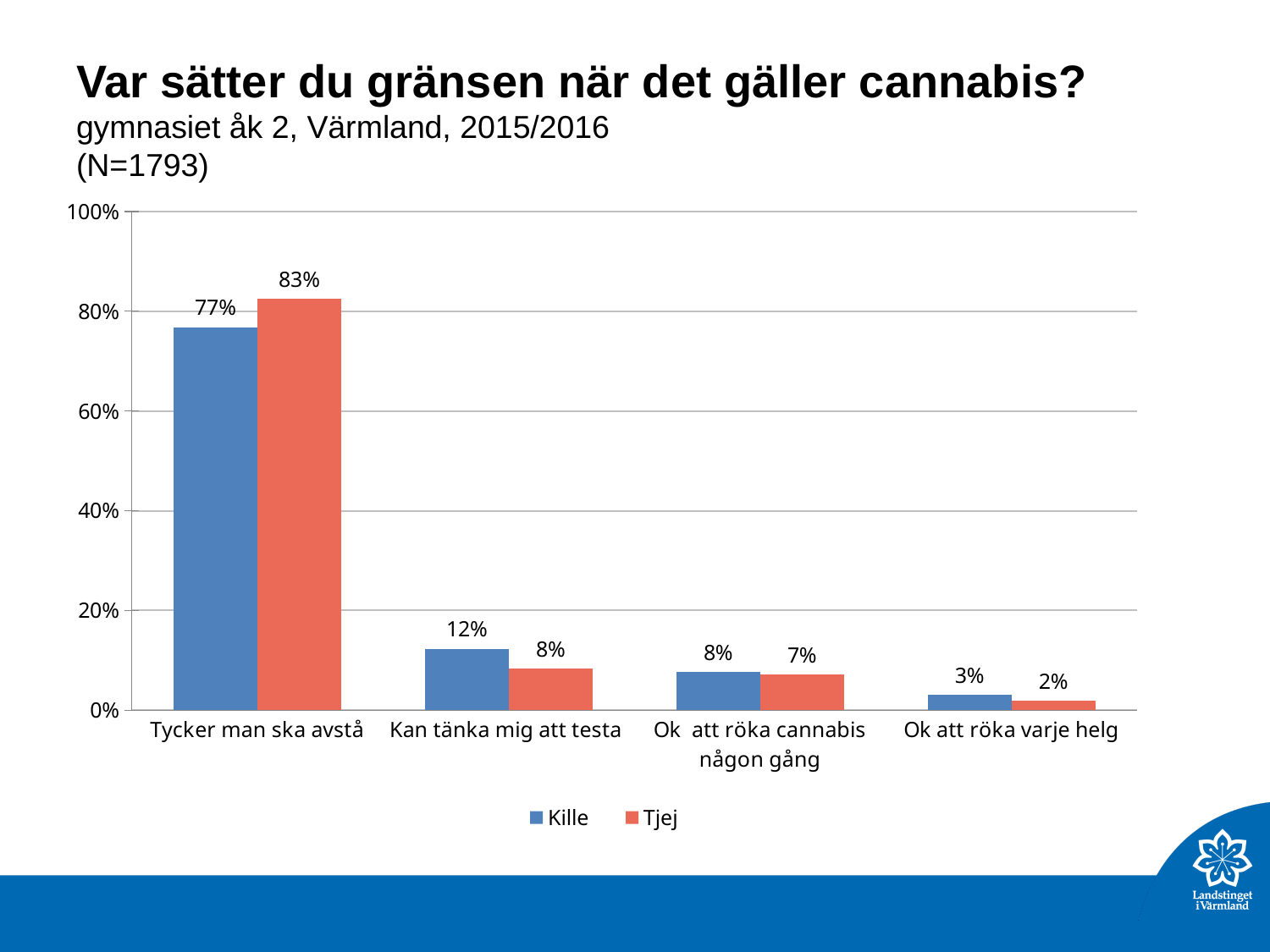
What is the difference between the Kille and Tjej values for "Kan tänka mig att testa"? 4% What is the difference between the Tjej and Kille values for "Tycker man ska avstå"? 6% How many series does the legend list? 2 Is the value for Kille in "Tycker man ska avstå" greater or less than 60%? greater What kind of chart is shown on the slide? Bar chart How many categories are shown on the x axis? 4 Which is larger for "Ok att röka cannabis någon gång": Kille or Tjej? Kille What is the value for Tjej in the category "Ok att röka varje helg"? 2% What is the value for Kille in the category "Tycker man ska avstå"? 77% Which category has the lowest value for Kille? Ok att röka varje helg What is the value for Tjej in the category "Kan tänka mig att testa"? 8% Which category has the highest value for Tjej? Tycker man ska avstå